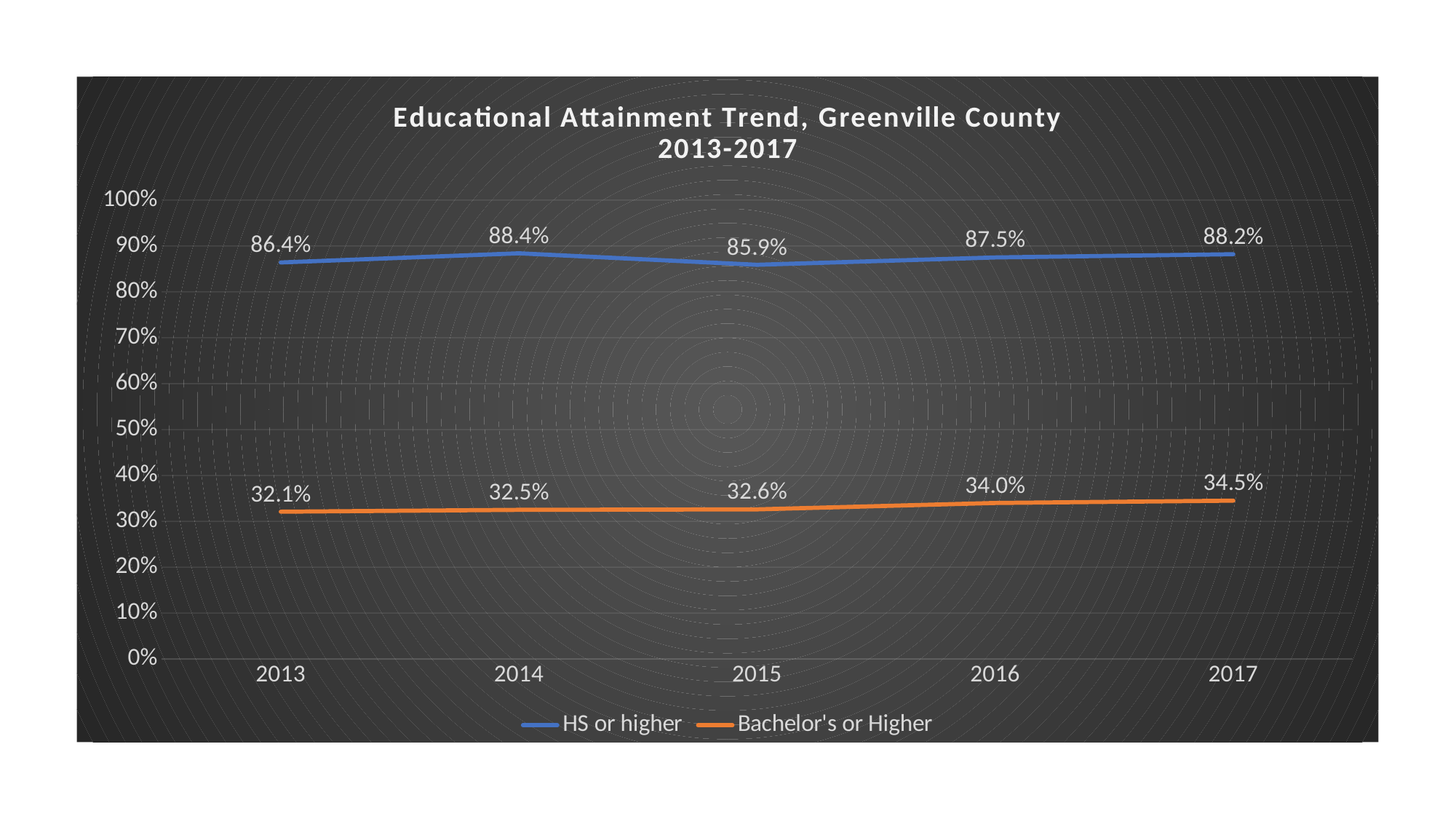
Does the Bachelor's or Higher series rise or fall from 2013 to 2017? rise What is the value for Bachelor's or Higher in 2013? 32.1% How many years are shown on the x axis? 5 In which year is the Bachelor's or Higher value lowest? 2013 In which year is the HS or higher value highest? 2014 What is the difference between the HS or higher value in 2014 and in 2015? 2.5% What is the value for HS or higher in 2015? 85.9% How many series does the legend list? 2 What is the value for Bachelor's or Higher in 2017? 34.5% Which is larger, the HS or higher value in 2016 or in 2017? 2017 What is the difference between the Bachelor's or Higher value in 2017 and in 2013? 2.4% What kind of chart is this? line chart